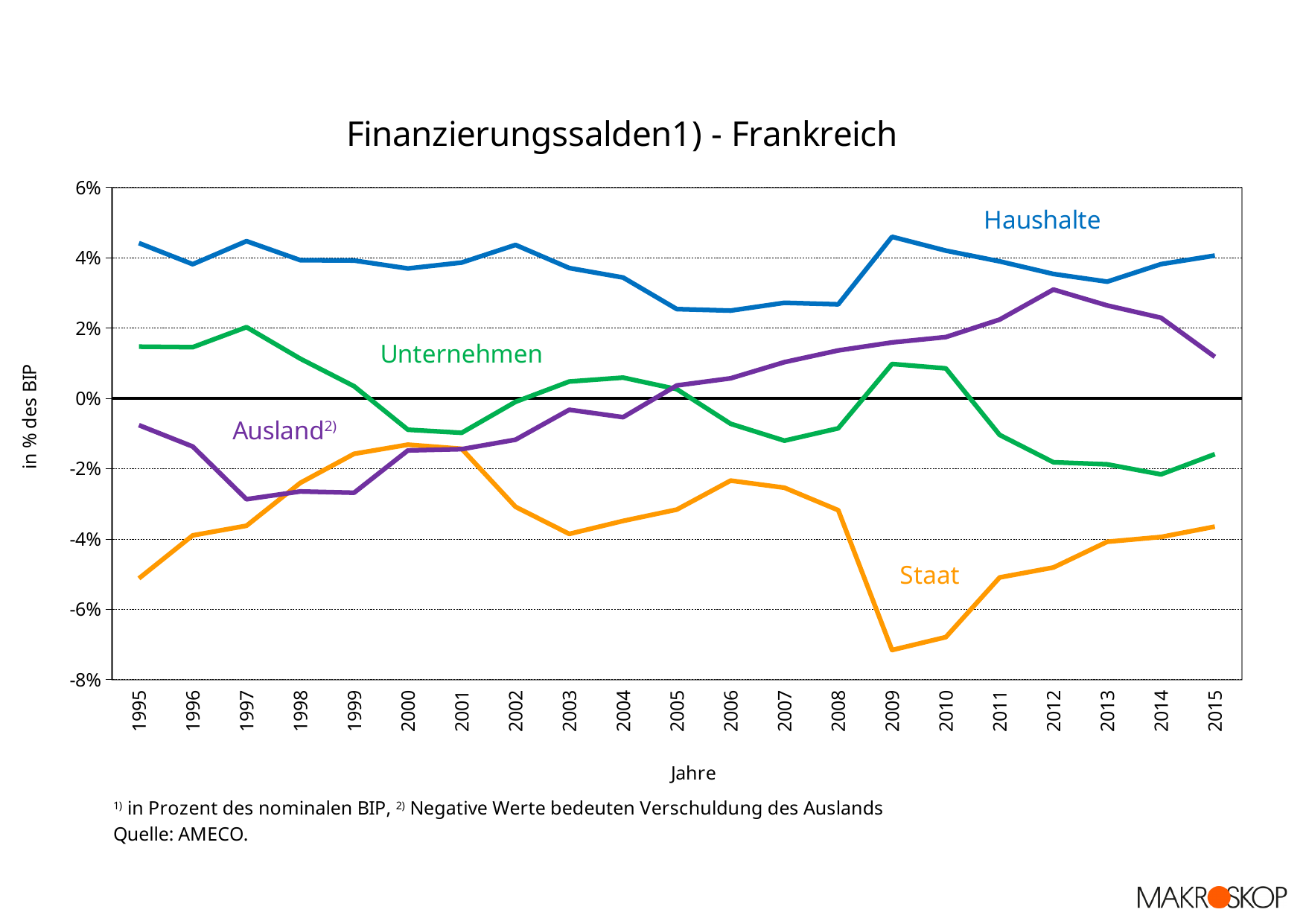
Is the value for Staat in 2009 greater or less than -6%? less Does the Staat series rise or fall from 2009 to 2015? rise How many series are plotted in the chart? 4 How many years are shown on the x axis? 21 What kind of chart is shown on the slide? line chart In 2000, which is larger: the value for Haushalte or the value for Unternehmen? Haushalte In which year does the Staat series reach its lowest value? 2009 What is the title of the chart? Finanzierungssalden1) - Frankreich Is the value for Ausland in 2012 greater or less than 2%? greater Which series has the lowest value in 2009? Staat Is the value for Ausland in 1997 greater or less than -2%? less